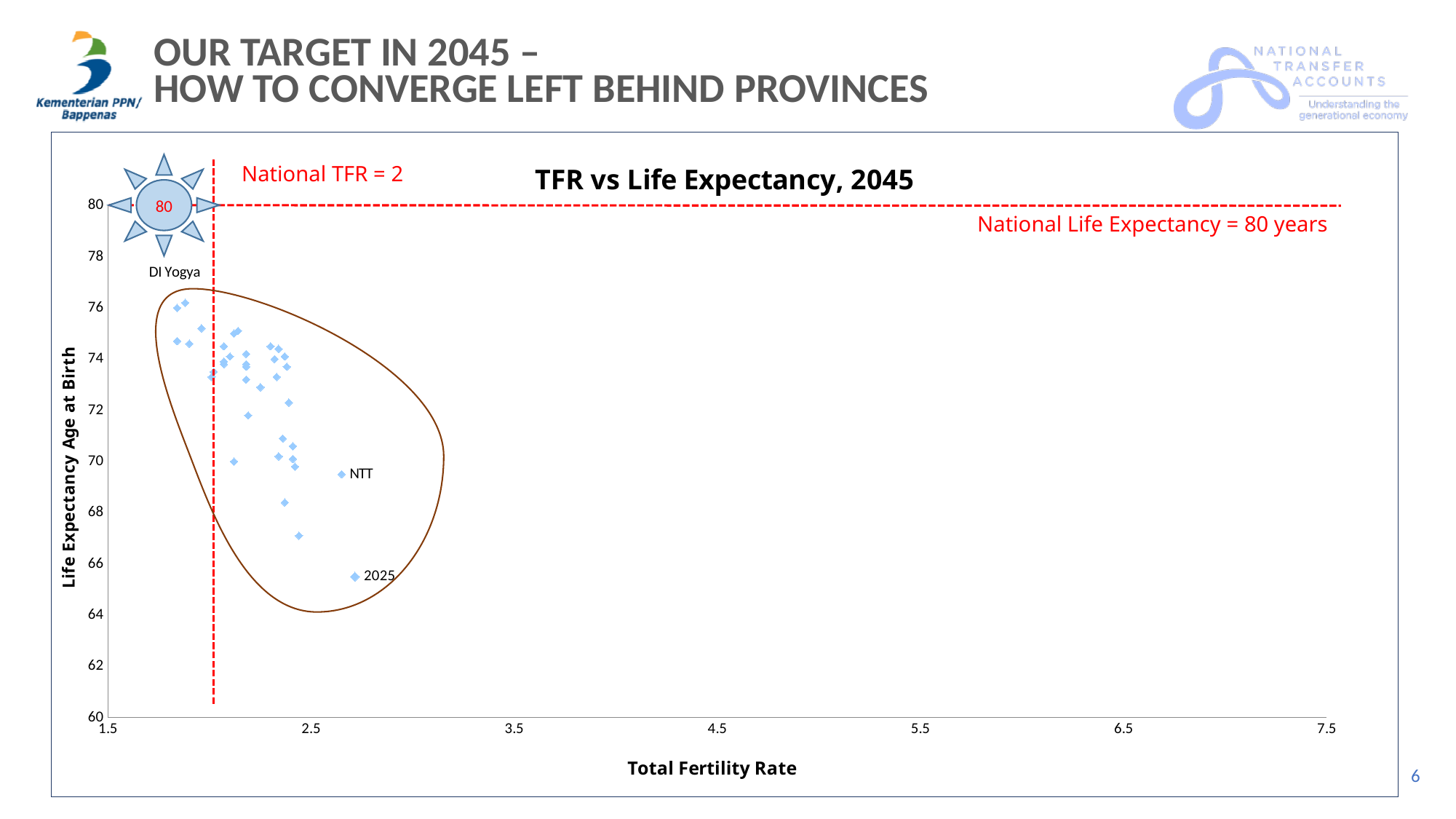
Of the labelled points DI Yogya, NTT and 2025, which has the lowest life expectancy? 2025 What kind of chart is shown on the slide? Scatter chart What value does the vertical red dashed line mark as the National TFR? 2 What is the label of the horizontal axis of the chart? Total Fertility Rate Is the life expectancy for the point labelled 2025 greater or less than 68? less What value does the horizontal red dashed line mark as the National Life Expectancy? 80 years Is the Total Fertility Rate for the point labelled DI Yogya greater or less than 2? less As the Total Fertility Rate increases along the x axis, does life expectancy generally rise or fall? fall What is the title of the chart? TFR vs Life Expectancy, 2045 Is the life expectancy for the point labelled NTT greater or less than 68? greater Which has the higher life expectancy, the point labelled NTT or the point labelled 2025? NTT